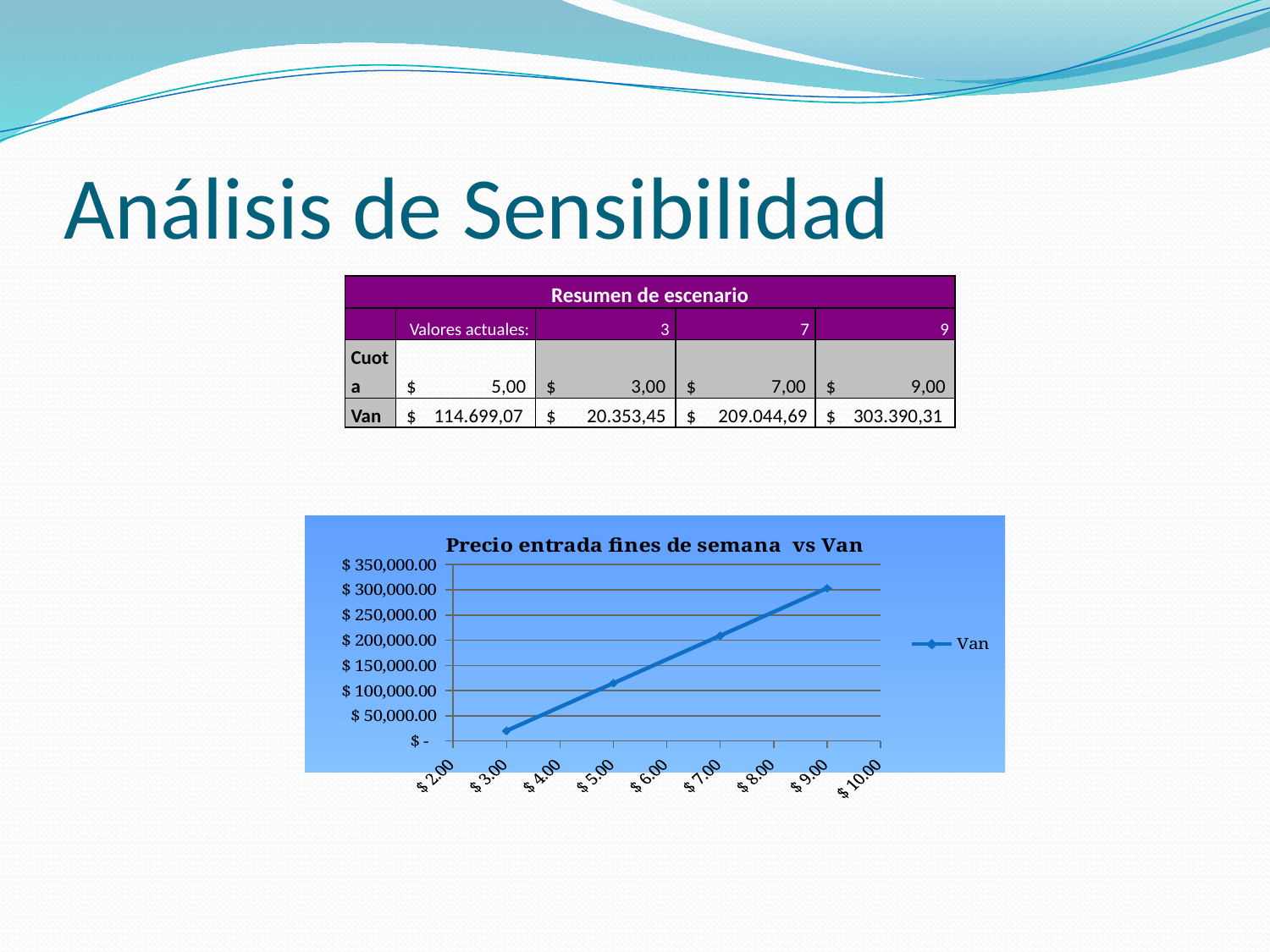
What is the name of the series shown in the chart legend? Van Which has the larger Van value, $ 5.00 or $ 7.00? $ 7.00 Is the Van value at $ 9.00 greater or less than $ 250,000.00? greater How many series does the chart legend list? 1 How many data points are plotted on the Van line? 4 At which x-axis price is the Van value highest? $ 9.00 Is the Van value at $ 5.00 greater or less than $ 100,000.00? greater What is the title of the chart? Precio entrada fines de semana vs Van What kind of chart is shown on the slide? line chart Is the Van value at $ 3.00 greater or less than $ 50,000.00? less At which x-axis price is the Van value lowest? $ 3.00 Do the Van values rise or fall as the price on the x axis increases? rise